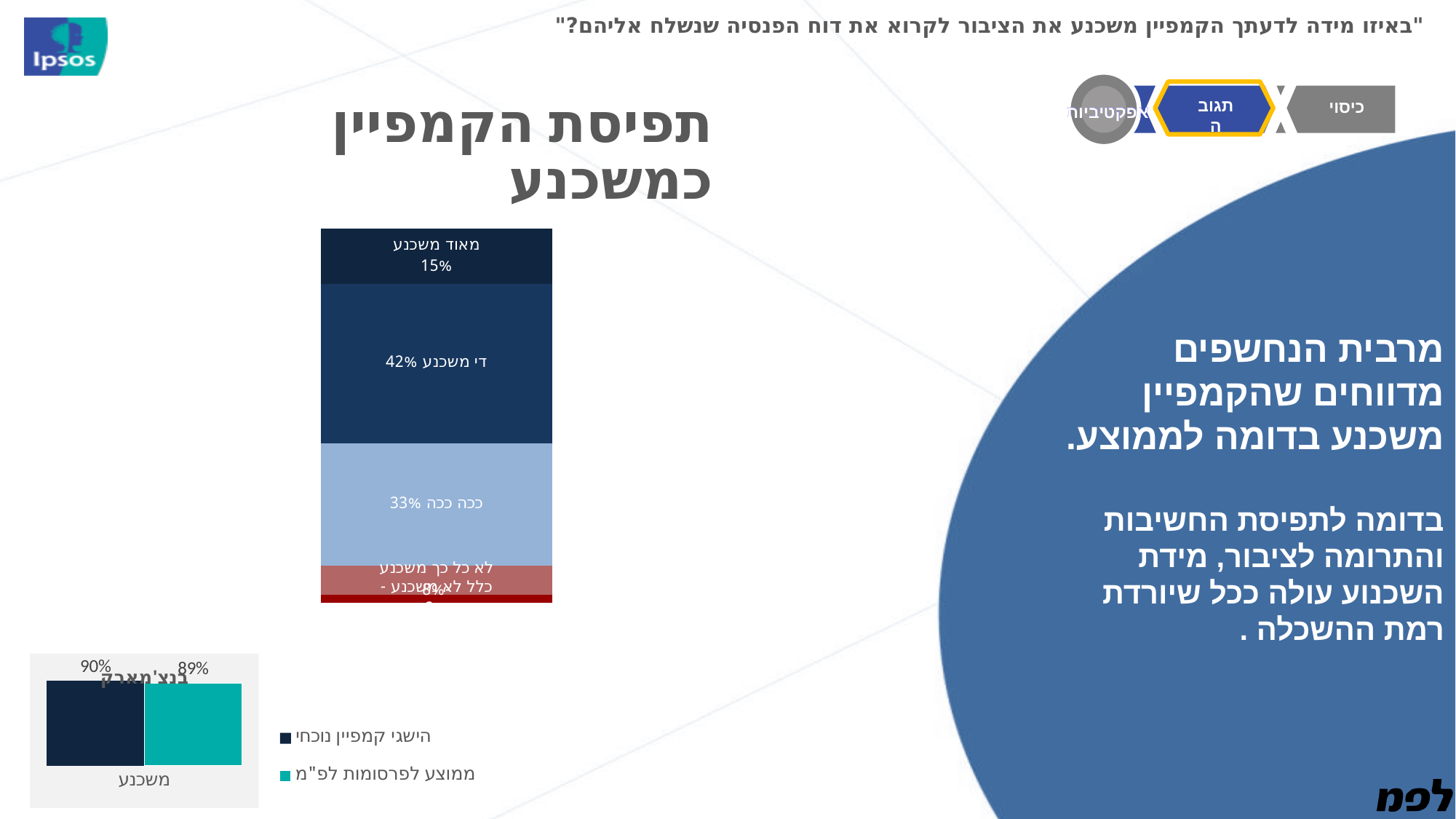
In the stacked bar chart titled "תפיסת הקמפיין כמשכנע", what is the value for "די משכנע"? 42% In the stacked bar chart titled "תפיסת הקמפיין כמשכנע", which is larger: "מאוד משכנע" or "ככה ככה"? ככה ככה What is the category label on the x axis of the bottom-left chart titled "בנצ'מארק"? משכנע In the stacked bar chart titled "תפיסת הקמפיין כמשכנע", what is the difference between "די משכנע" and "ככה ככה"? 9 percentage points In the stacked bar chart titled "תפיסת הקמפיין כמשכנע", what is the value for "מאוד משכנע"? 15% How many series does the legend of the bottom-left chart titled "בנצ'מארק" list? 2 What kind of chart is the chart titled "תפיסת הקמפיין כמשכנע"? Stacked bar chart In the stacked bar chart titled "תפיסת הקמפיין כמשכנע", what is the value for "ככה ככה"? 33% In the stacked bar chart titled "תפיסת הקמפיין כמשכנע", which segment has the largest value? די משכנע In the bottom-left chart titled "בנצ'מארק", what is the value for "הישגי קמפיין נוכחי"? 90% In the bottom-left chart titled "בנצ'מארק", what is the value for "ממוצע לפרסומות לפ"מ"? 89% In the bottom-left chart titled "בנצ'מארק", what is the difference between "הישגי קמפיין נוכחי" and "ממוצע לפרסומות לפ"מ"? 1 percentage point